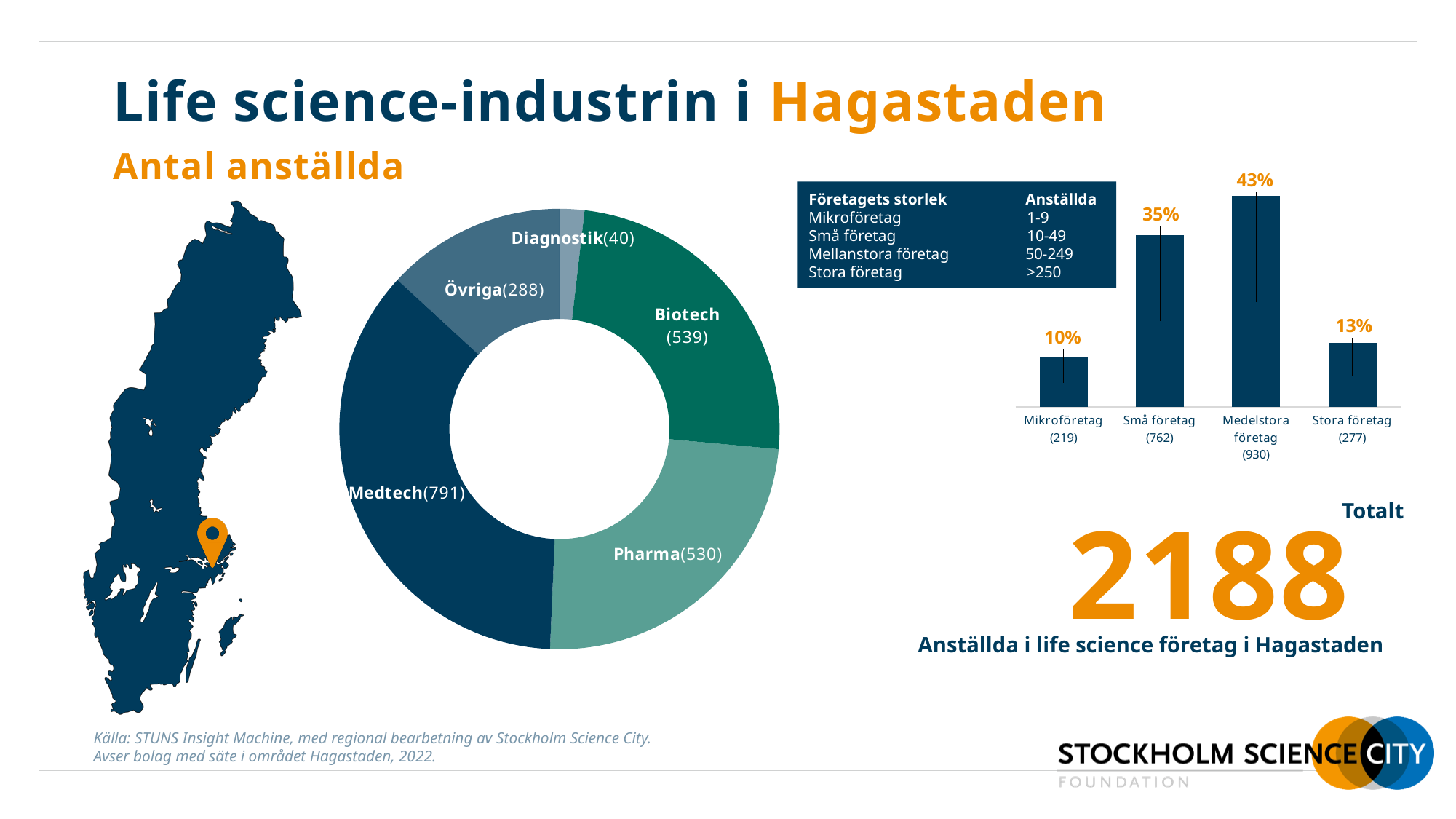
In the bar chart on the right, which is larger: Mikroföretag or Stora företag? Stora företag In the bar chart on the right, which company size category has the lowest percentage? Mikroföretag In the bar chart on the right, what percentage is shown for Medelstora företag? 43% In the donut chart, which sector has the highest number of employees? Medtech In the donut chart, which sector has the lowest number of employees? Diagnostik In the bar chart on the right, which company size category has the highest percentage? Medelstora företag How many bars are shown in the bar chart on the right? 4 What kind of chart is the chart on the right of the slide? Bar chart How many sectors are shown in the donut chart? 5 In the bar chart on the right, what is the difference in percentage points between Små företag and Stora företag? 22 percentage points In the donut chart, what is the difference between the Biotech and Pharma values? 9 In the donut chart, how many employees are shown for Medtech? 791